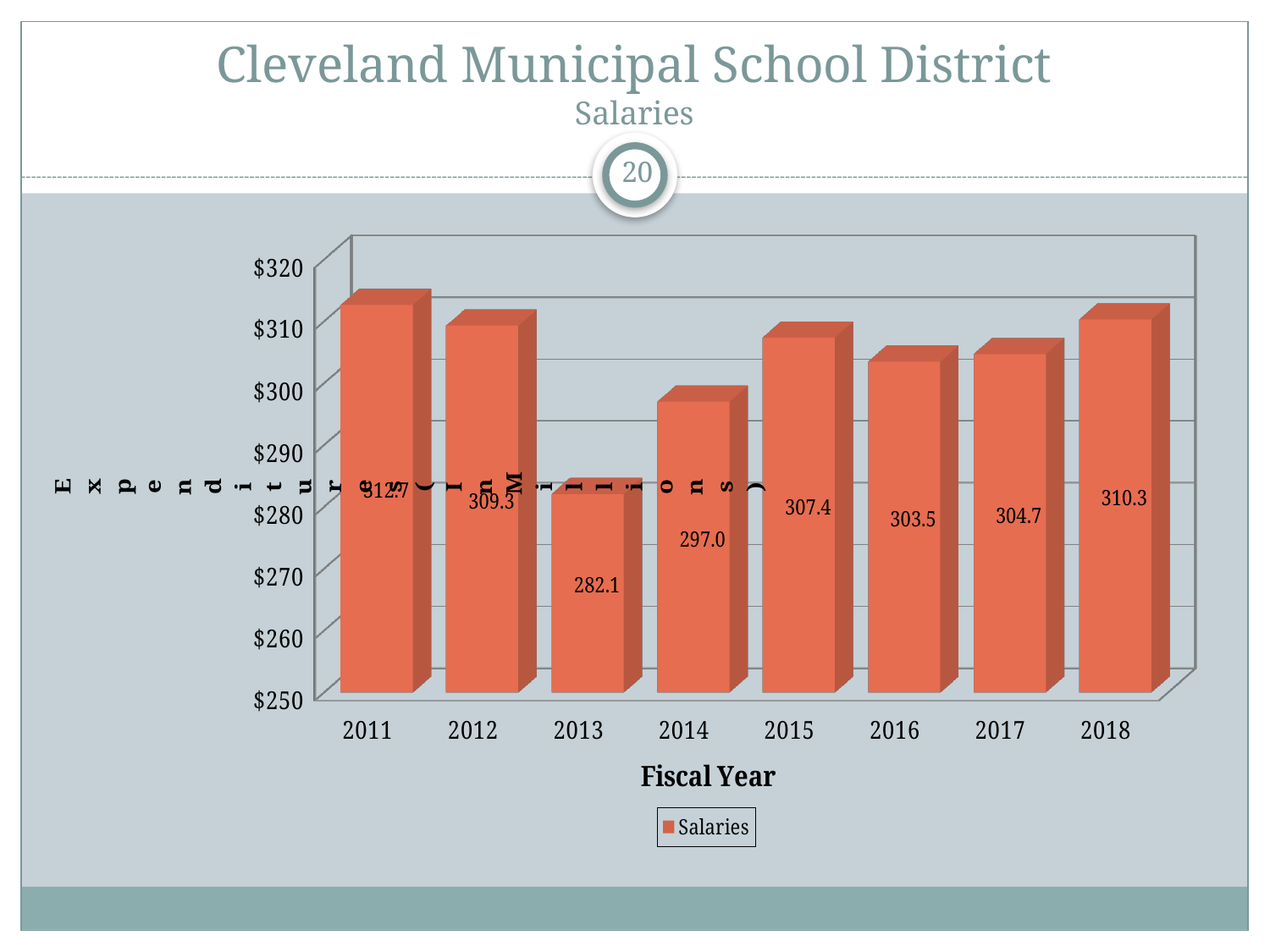
What is the value for fiscal year 2016? 303.5 Which fiscal year has the lowest salaries value? 2013 What is the difference between the values for 2018 and 2017? 5.6 What is the value for fiscal year 2018? 310.3 Do the values rise or fall from 2013 to 2015? rise How many series does the legend list? 1 How many fiscal years are shown on the x axis? 8 What kind of chart is shown on the slide? bar chart Is the value for 2014 greater or less than $300? less What is the difference between the values for 2015 and 2014? 10.4 What is the value for fiscal year 2013? 282.1 Which is larger, the value for 2012 or the value for 2017? 2012